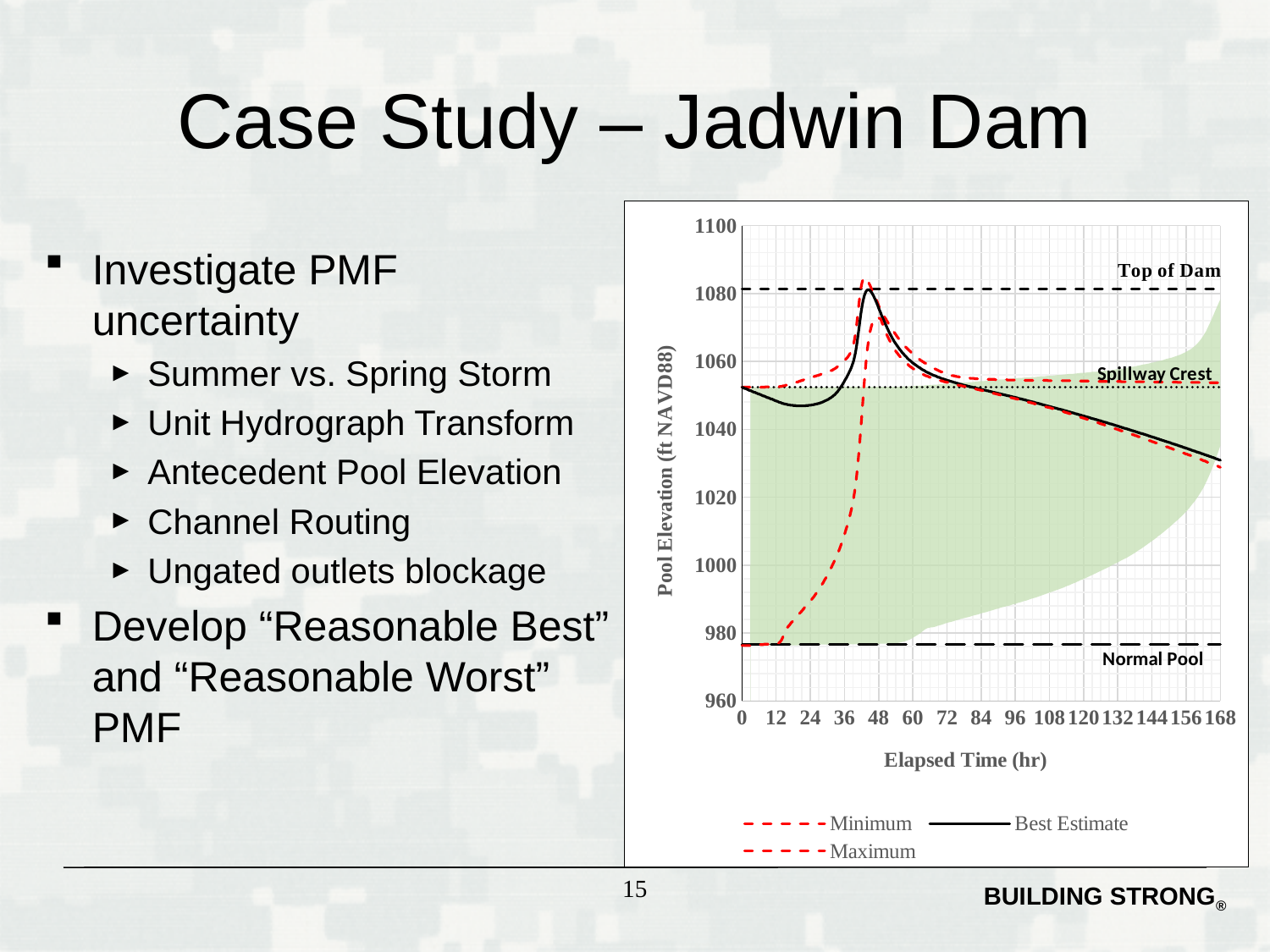
Does the Best Estimate series rise or fall between 48 hours and 168 hours? fall Is the value of the Best Estimate series at 168 hours greater or less than 1040? less At 24 hours, which is larger: the Maximum series or the Minimum series? Maximum How many tick labels are shown on the Elapsed Time (hr) axis? 15 How many series does the chart legend list? 3 What are the three series named in the chart legend? Minimum, Best Estimate, Maximum Is the value of the Minimum series at 12 hours greater or less than 1000? less Which series has the lowest pool elevation at 24 hours? Minimum What is the title of the chart's vertical axis? Pool Elevation (ft NAVD88) Is the peak value of the Best Estimate series greater or less than 1060? greater What kind of chart is shown on the slide? line chart